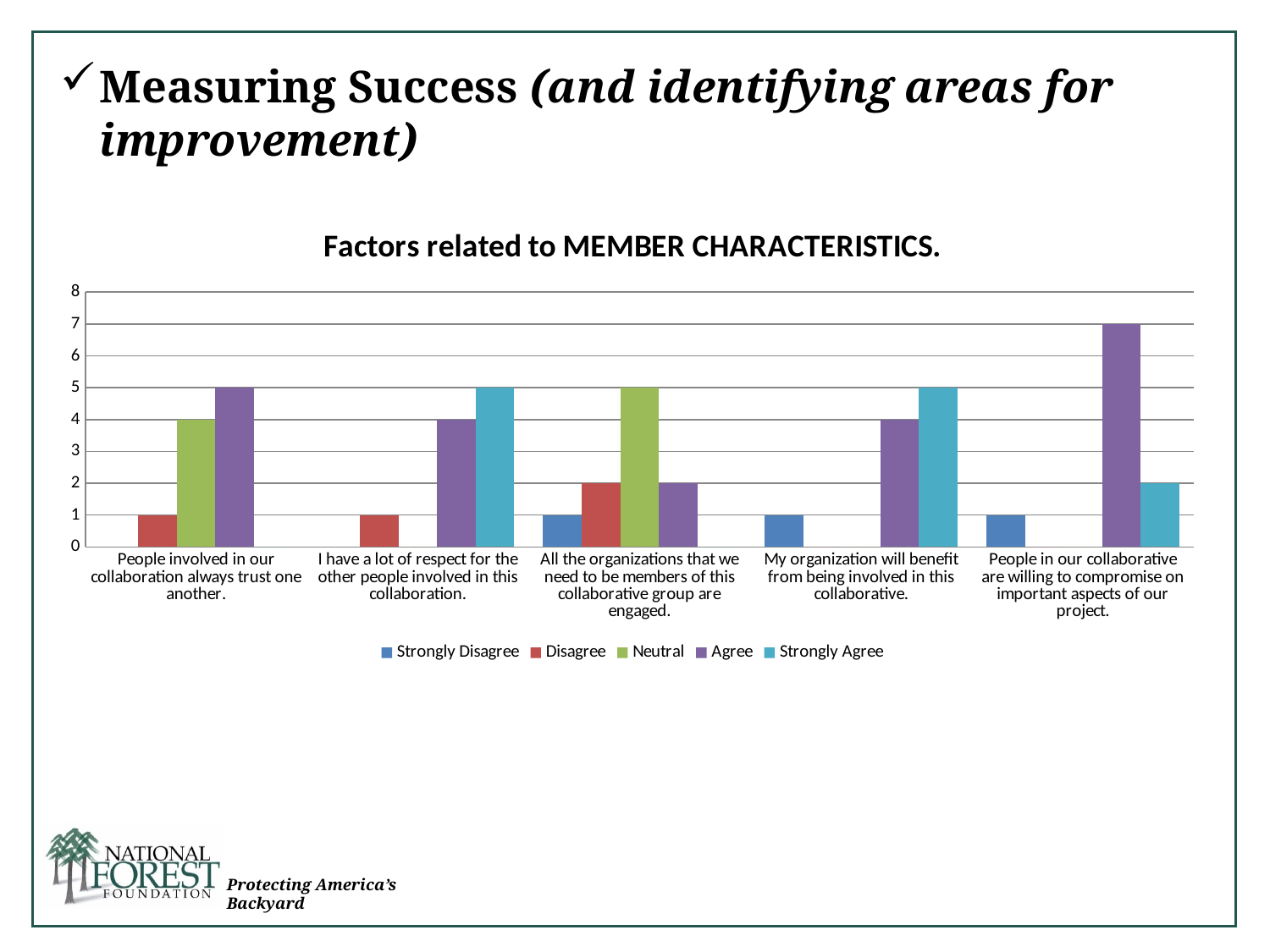
What is the Disagree value for "All the organizations that we need to be members of this collaborative group are engaged."? 2 What is the title of the chart? Factors related to MEMBER CHARACTERISTICS. What is the difference between the Agree and Strongly Agree values for "People in our collaborative are willing to compromise on important aspects of our project."? 5 What is the Strongly Agree value for "I have a lot of respect for the other people involved in this collaboration."? 5 How many statement categories are shown on the x axis? 5 For "People involved in our collaboration always trust one another.", which is larger: the Neutral value or the Agree value? Agree Which statement has the highest Agree value? People in our collaborative are willing to compromise on important aspects of our project. What is the Neutral value for "All the organizations that we need to be members of this collaborative group are engaged."? 5 How many series does the legend list? 5 Is the Agree value for "People in our collaborative are willing to compromise on important aspects of our project." greater or less than 6? greater What is the Agree value for "People in our collaborative are willing to compromise on important aspects of our project."? 7 What type of chart is shown on the slide? Bar chart